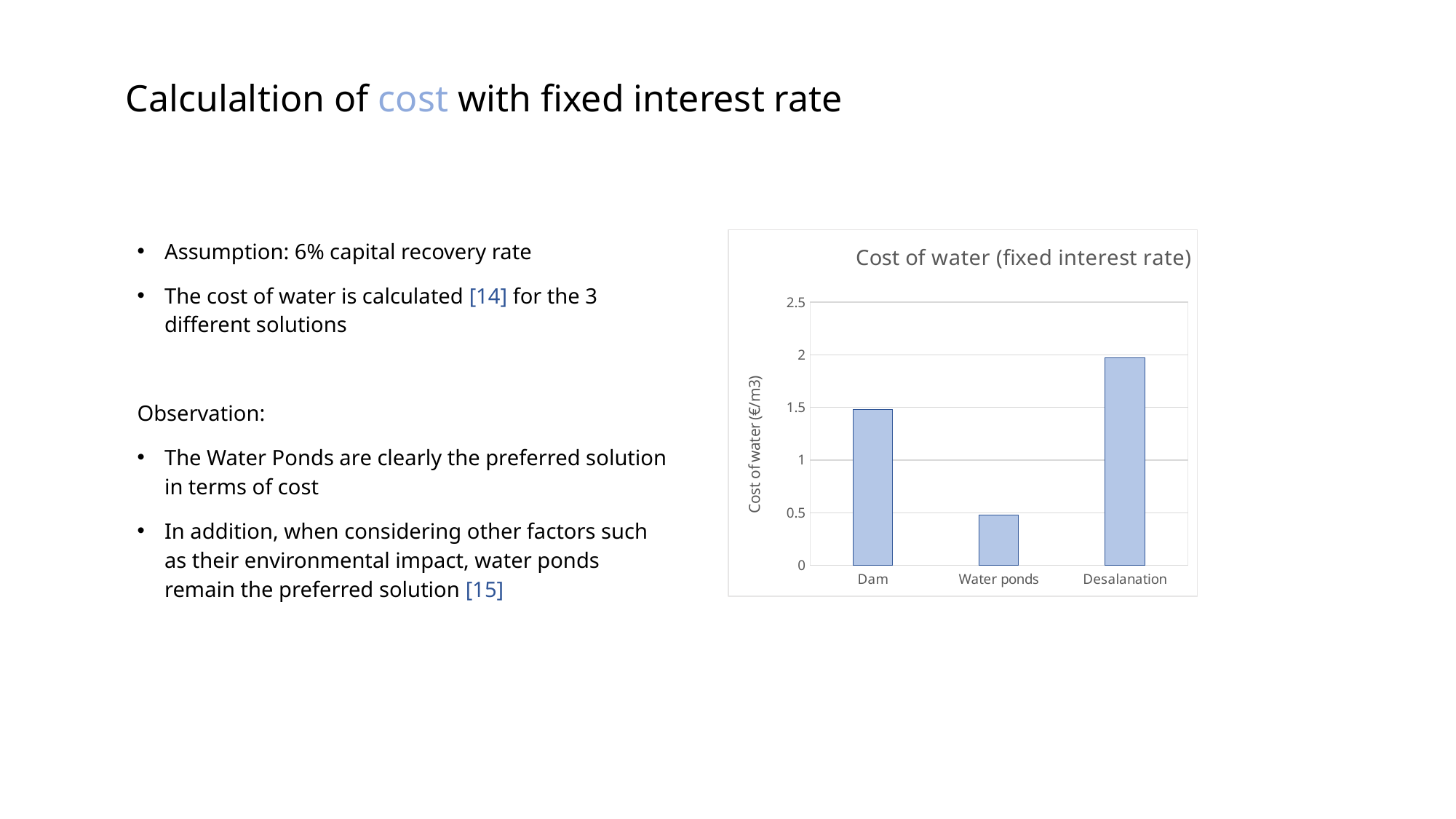
Is the value for Water ponds greater or less than 1? less Is the value for Desalanation greater or less than 1.5? greater Which category has the highest cost of water? Desalanation How many categories are shown on the x axis of the chart? 3 Is the value for Dam greater or less than 2? less What is the title of the chart? Cost of water (fixed interest rate) Which category has the lowest cost of water? Water ponds Which has a higher cost of water, Desalanation or Dam? Desalanation What is the label of the vertical axis of the chart? Cost of water (€/m3) What kind of chart is shown on the slide? bar chart Which has a higher cost of water, Dam or Water ponds? Dam